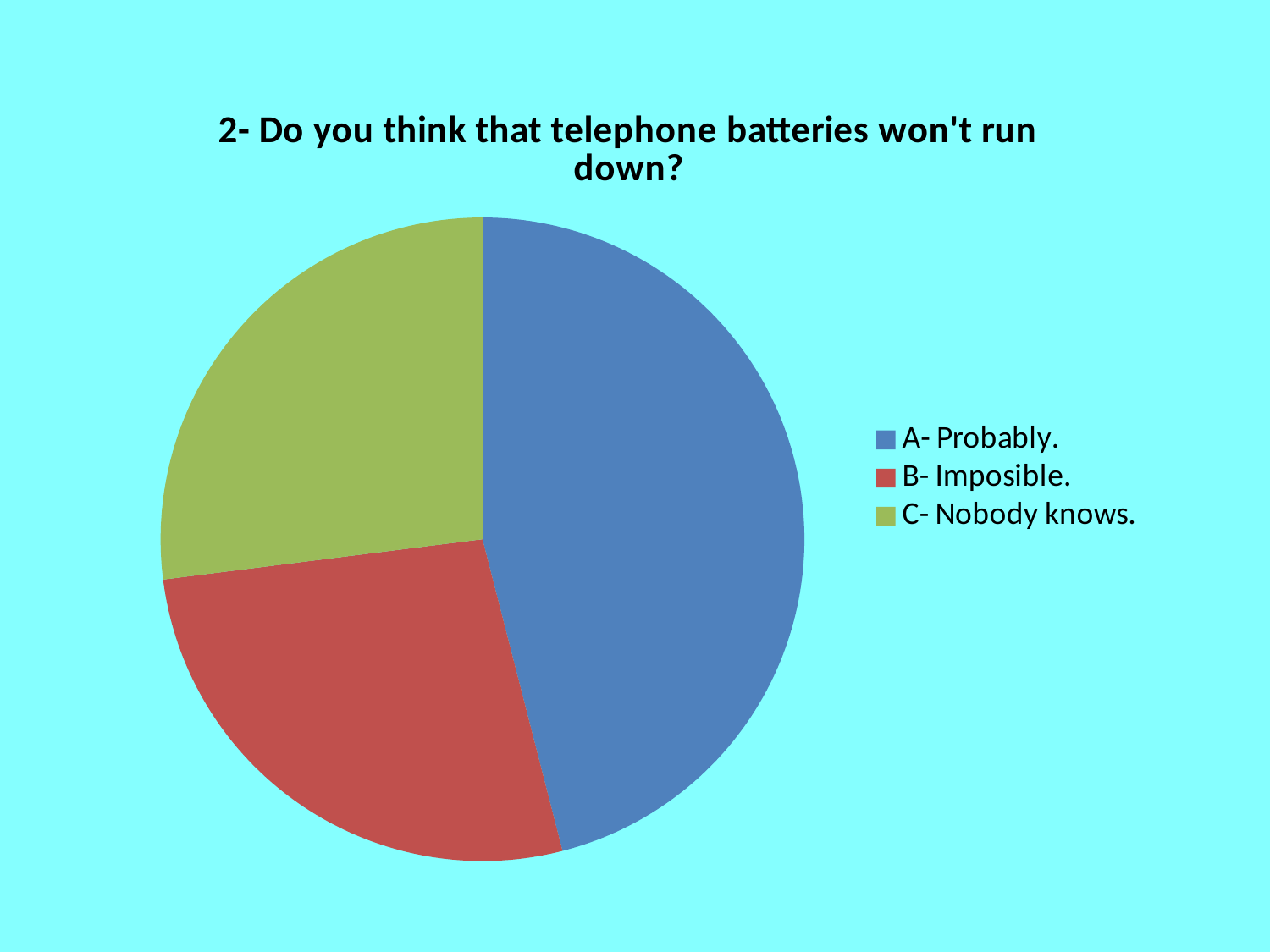
How many entries does the legend list? 3 What kind of chart is shown on the slide? Pie chart Does the slice for A- Probably. take up more or less than half of the pie? less Which answer option has the largest slice of the pie? A- Probably. What colour is the slice for C- Nobody knows.? Green What is the title of the chart? 2- Do you think that telephone batteries won't run down? Which slice is larger, A- Probably. or C- Nobody knows.? A- Probably. How many slices does the pie chart have? 3 Which slice is larger, A- Probably. or B- Imposible.? A- Probably.